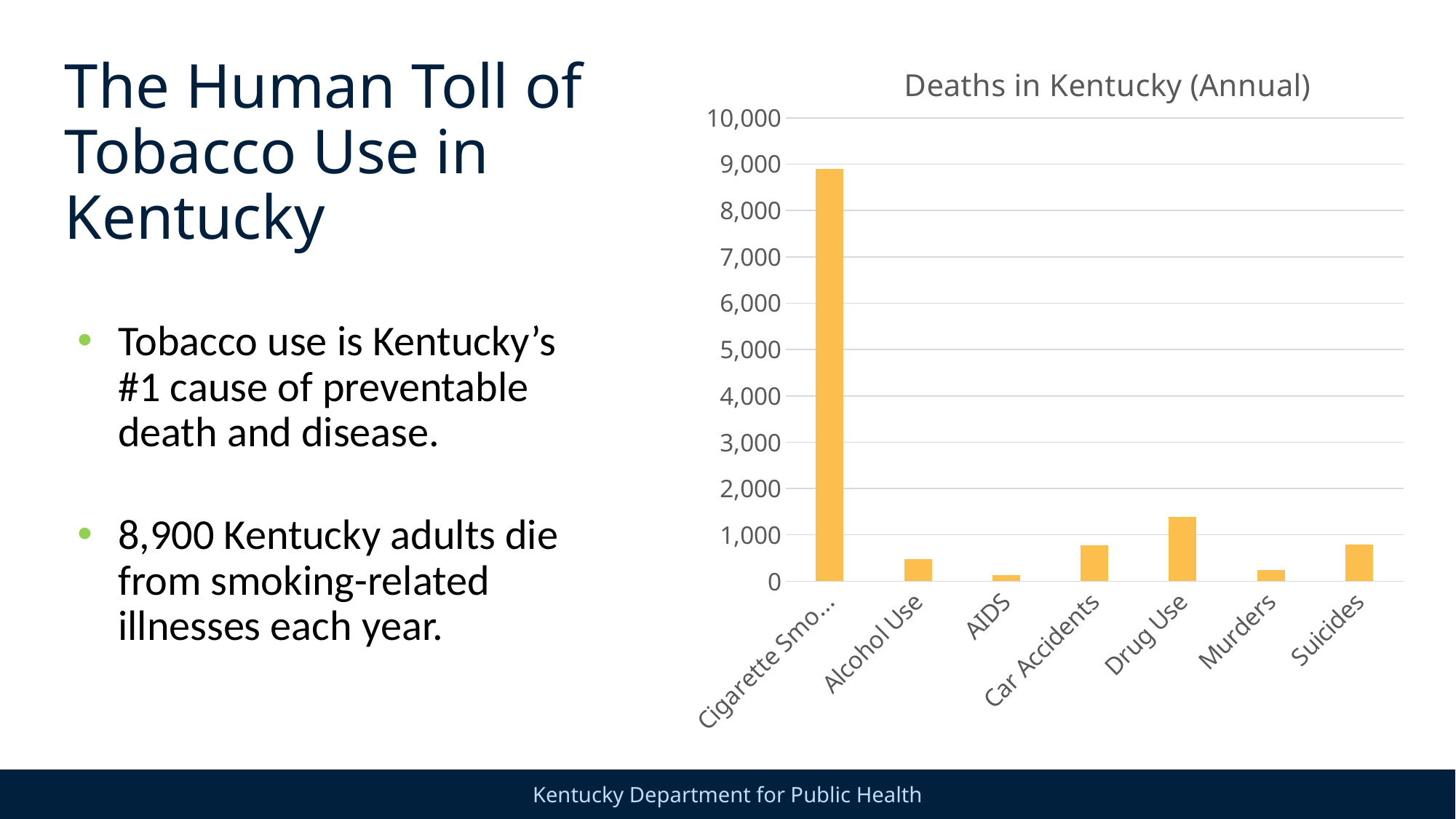
Is the value for Drug Use greater or less than 1,000? greater What kind of chart is shown on the slide? Bar chart Is the value for Murders greater or less than 500? less Which category has the highest number of deaths in the chart? Cigarette Smoking Which is larger, the value for Drug Use or the value for Alcohol Use? Drug Use What is the highest value shown on the chart's vertical axis? 10,000 Which is larger, the value for Murders or the value for AIDS? Murders Is the value for Car Accidents greater or less than 1,000? less How many categories are plotted in the chart? 7 Which category has the lowest number of deaths in the chart? AIDS What is the title of the chart? Deaths in Kentucky (Annual)